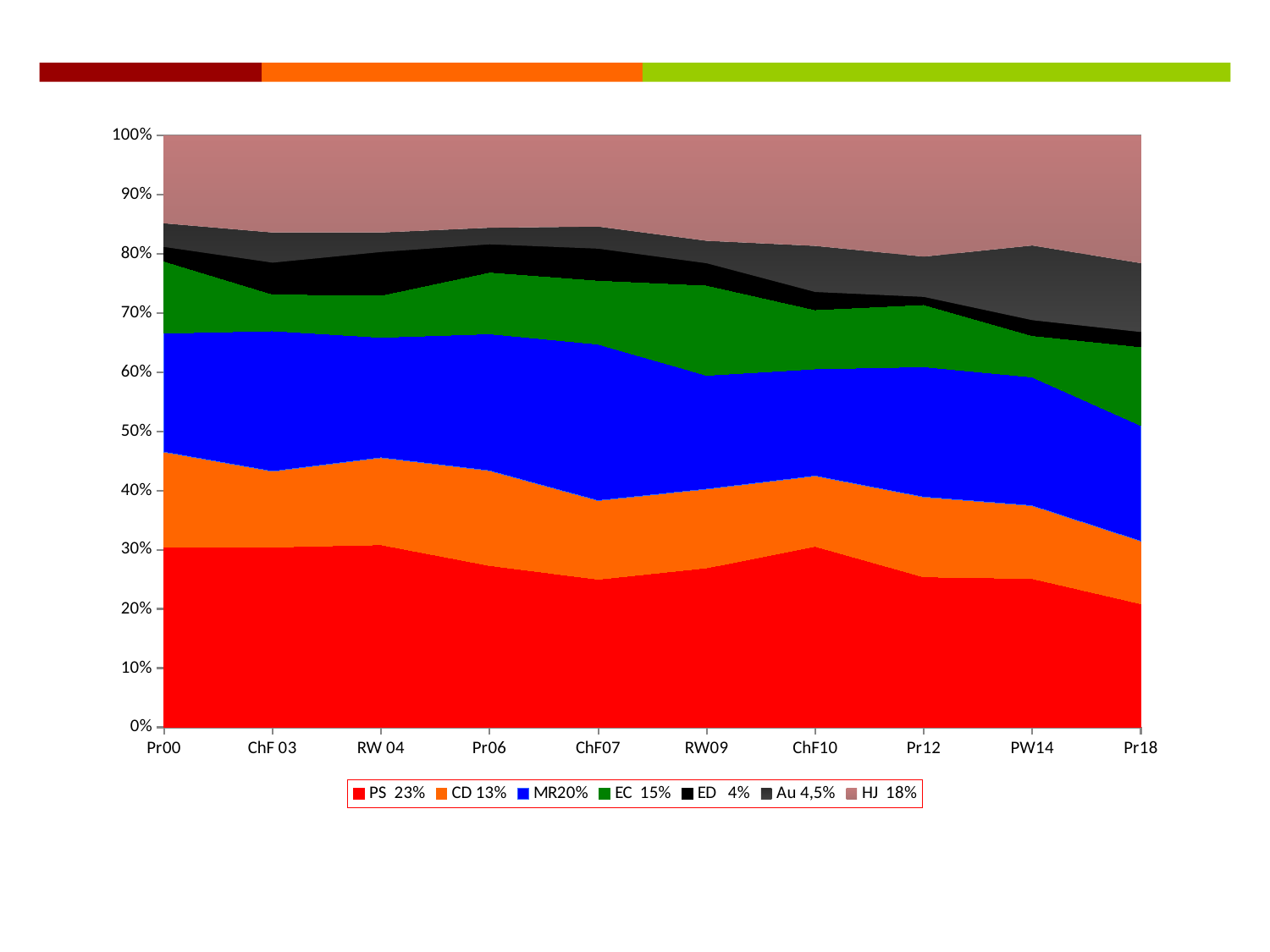
Is the value for PS at ChF07 greater or less than 30%? less Is the value for PS at RW 04 greater or less than 40%? less What percentage is shown next to HJ in the legend? 18% Does the PS series rise or fall overall from Pr00 to Pr18? Fall What kind of chart is shown on the slide? Stacked area chart How many categories are shown along the x axis? 10 Is the value for PS at Pr00 greater or less than 20%? greater At which category is the PS series lowest? Pr18 Is the value for PS larger at Pr00 or at Pr18? Pr00 How many series does the legend list? 7 What is the first category on the x axis? Pr00